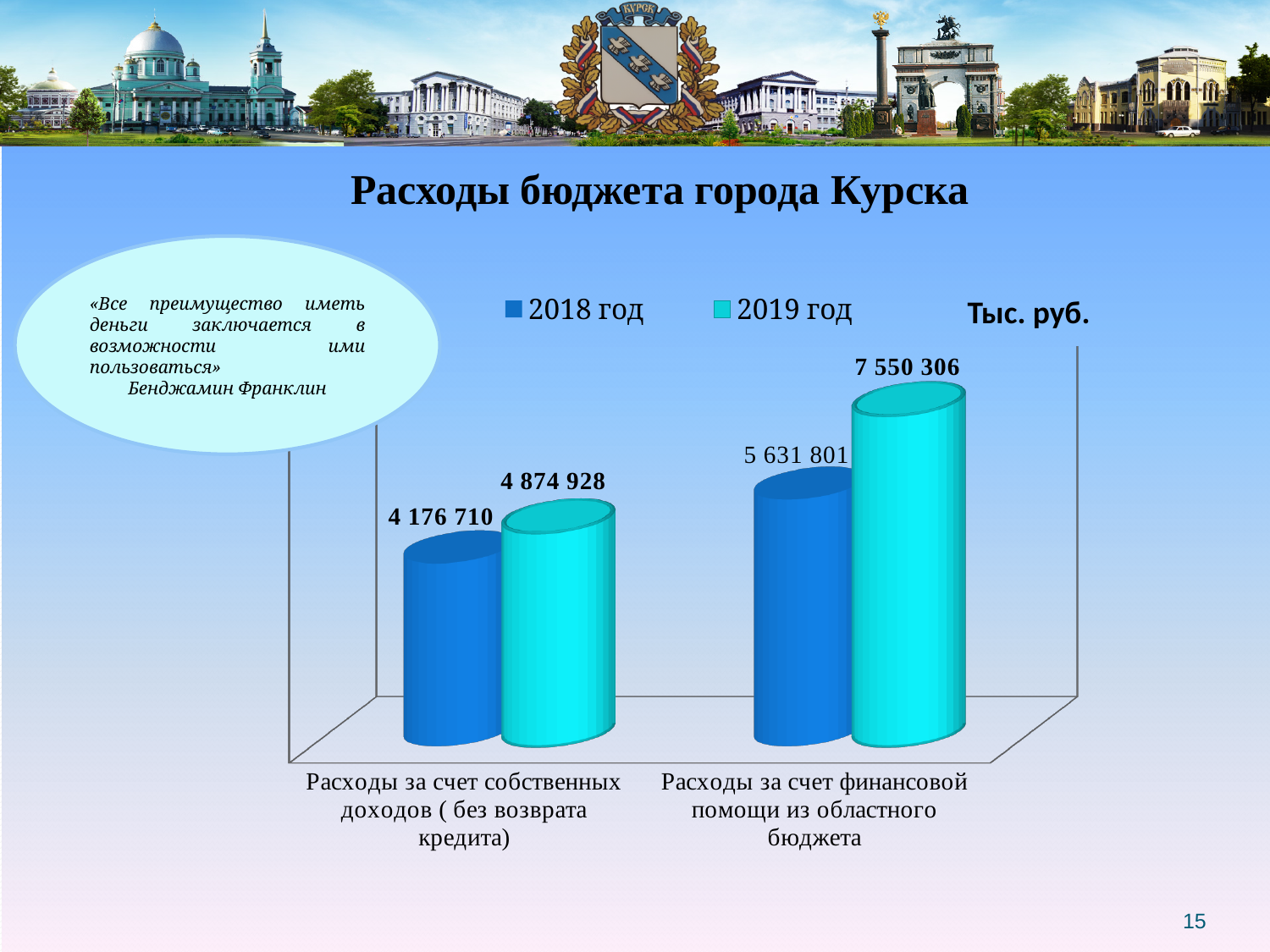
How many series does the chart legend list? 2 Which bar has the lowest value on the chart? 2018 год, Расходы за счет собственных доходов ( без возврата кредита) What is the value for 2019 год in the category "Расходы за счет собственных доходов ( без возврата кредита)"? 4 874 928 What is the difference between the 2019 год and 2018 год values for "Расходы за счет собственных доходов ( без возврата кредита)"? 698 218 What is the value for 2018 год in the category "Расходы за счет собственных доходов ( без возврата кредита)"? 4 176 710 How many categories are shown on the x axis of the chart? 2 Which bar has the highest value on the chart? 2019 год, Расходы за счет финансовой помощи из областного бюджета What kind of chart is shown on the slide? Bar chart Which is larger: the 2018 год value for "Расходы за счет финансовой помощи из областного бюджета" or the 2019 год value for "Расходы за счет собственных доходов ( без возврата кредита)"? 2018 год value for Расходы за счет финансовой помощи из областного бюджета What is the value for 2019 год in the category "Расходы за счет финансовой помощи из областного бюджета"? 7 550 306 What is the value for 2018 год in the category "Расходы за счет финансовой помощи из областного бюджета"? 5 631 801 What is the difference between the 2019 год and 2018 год values for "Расходы за счет финансовой помощи из областного бюджета"? 1 918 505